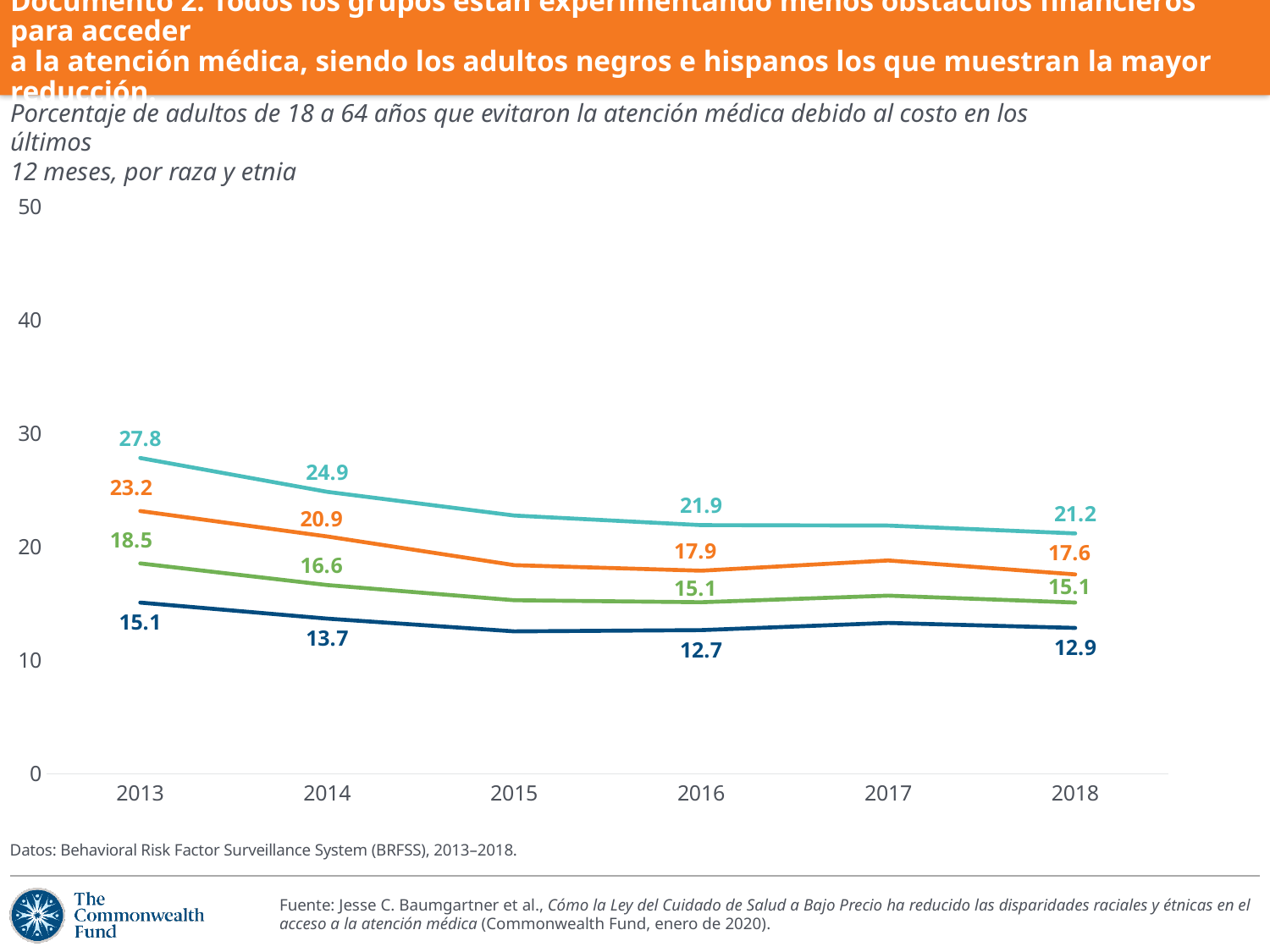
What is the value of the teal (top) line in 2013? 27.8 What is the value of the dark blue (bottom) line in 2018? 12.9 What kind of chart is shown on the slide? Line chart What is the value of the green line in 2014? 16.6 How many years are shown along the x axis of the chart? 6 How many lines are plotted on the chart? 4 Which line has the highest value in 2013? The teal line (27.8) Is the value of the teal line in 2015 greater or less than 20? greater Does the orange line generally rise or fall from 2013 to 2018? Fall By how much did the teal line fall from 2013 to 2018? 6.6 What is the value of the orange line in 2016? 17.9 Which line has the lowest value in 2018? The dark blue line (12.9)